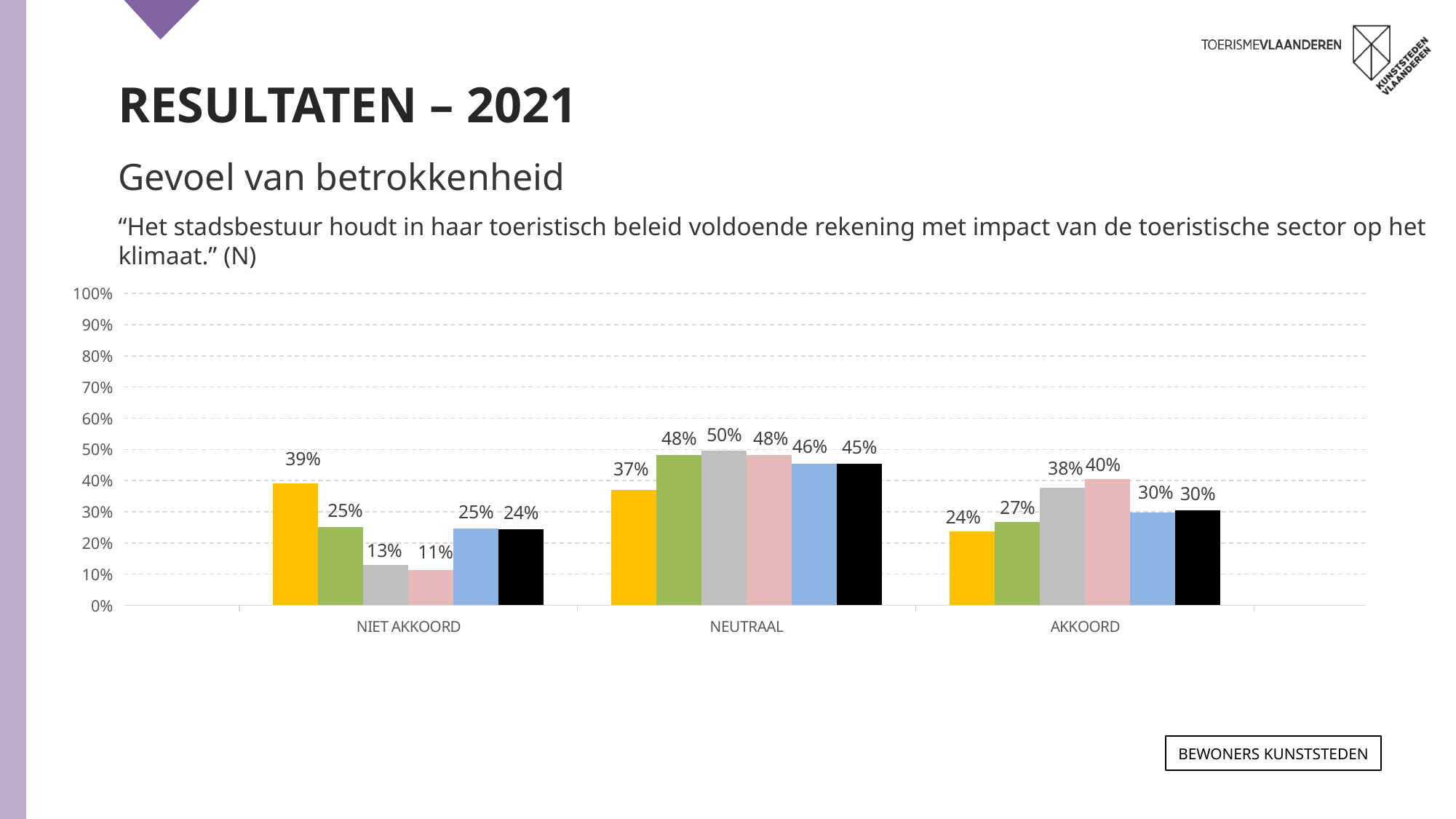
What is the value of the grey bar for NEUTRAAL? 50% How many categories are shown on the x axis of the chart? 3 What is the label of the middle category on the x axis? NEUTRAAL What is the value of the yellow bar for NIET AKKOORD? 39% Which category has the lowest value for the pink bar? NIET AKKOORD How many bars are plotted for each category in the chart? 6 What is the difference between the yellow bar and the pink bar for NIET AKKOORD? 28% Is the value of the black bar for NEUTRAAL greater or less than 40%? greater Which is larger for AKKOORD: the grey bar or the green bar? the grey bar What kind of chart is shown on the slide? bar chart What is the value of the pink bar for AKKOORD? 40% Which category has the highest value for the yellow bar? NIET AKKOORD